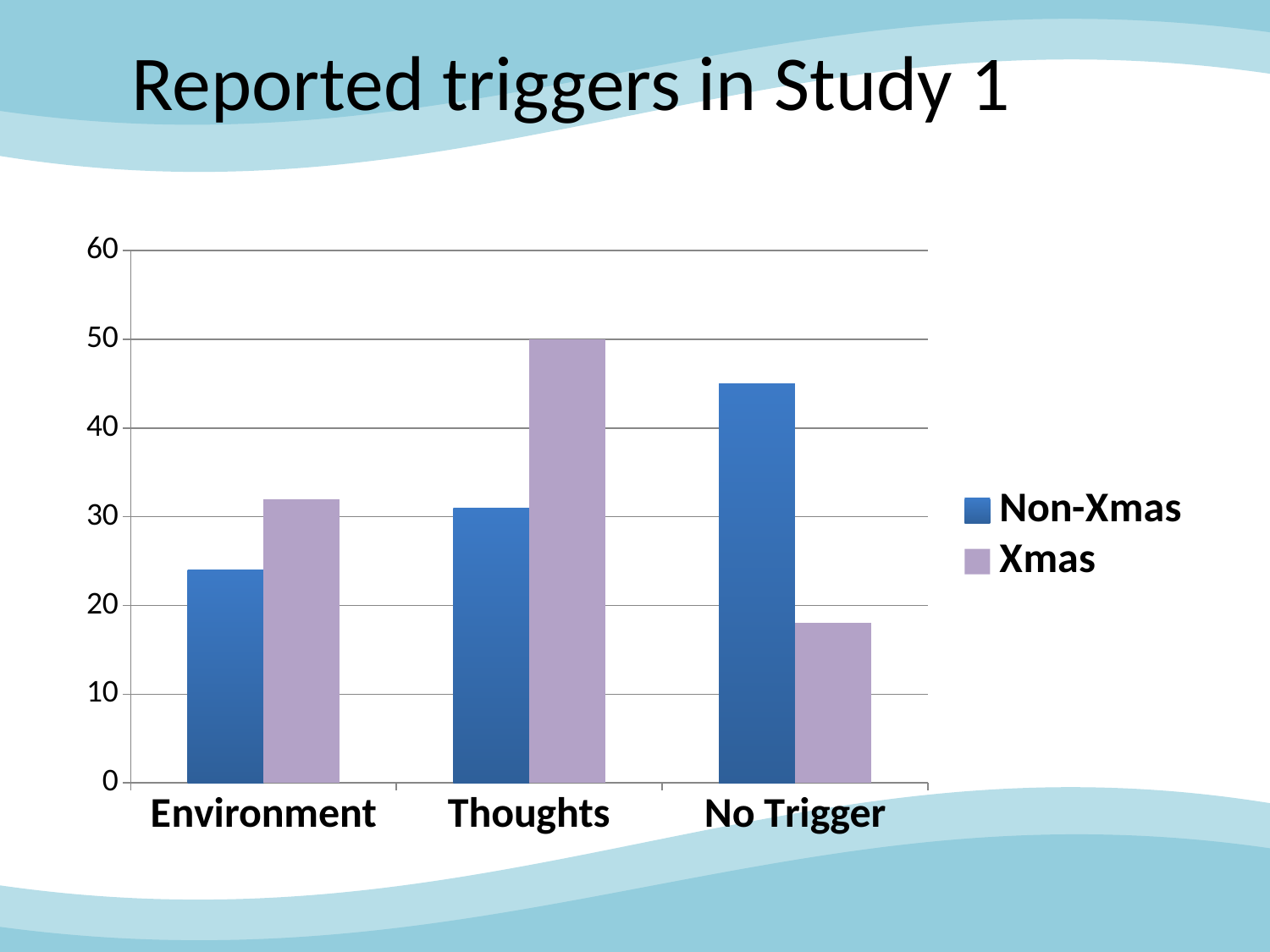
How many categories are shown on the x axis? 3 Which category has the highest Xmas value? Thoughts What kind of chart is shown on the slide? Bar chart How many series does the legend list? 2 Is the Xmas value for No Trigger greater or less than 20? less Is the Non-Xmas value for No Trigger greater or less than 40? greater For No Trigger, which series has the larger value, Non-Xmas or Xmas? Non-Xmas What is the title of the chart? Reported triggers in Study 1 Which category has the lowest Non-Xmas value? Environment Which category has the highest Non-Xmas value? No Trigger What is the Xmas value for Thoughts? 50 Which category has the lowest Xmas value? No Trigger